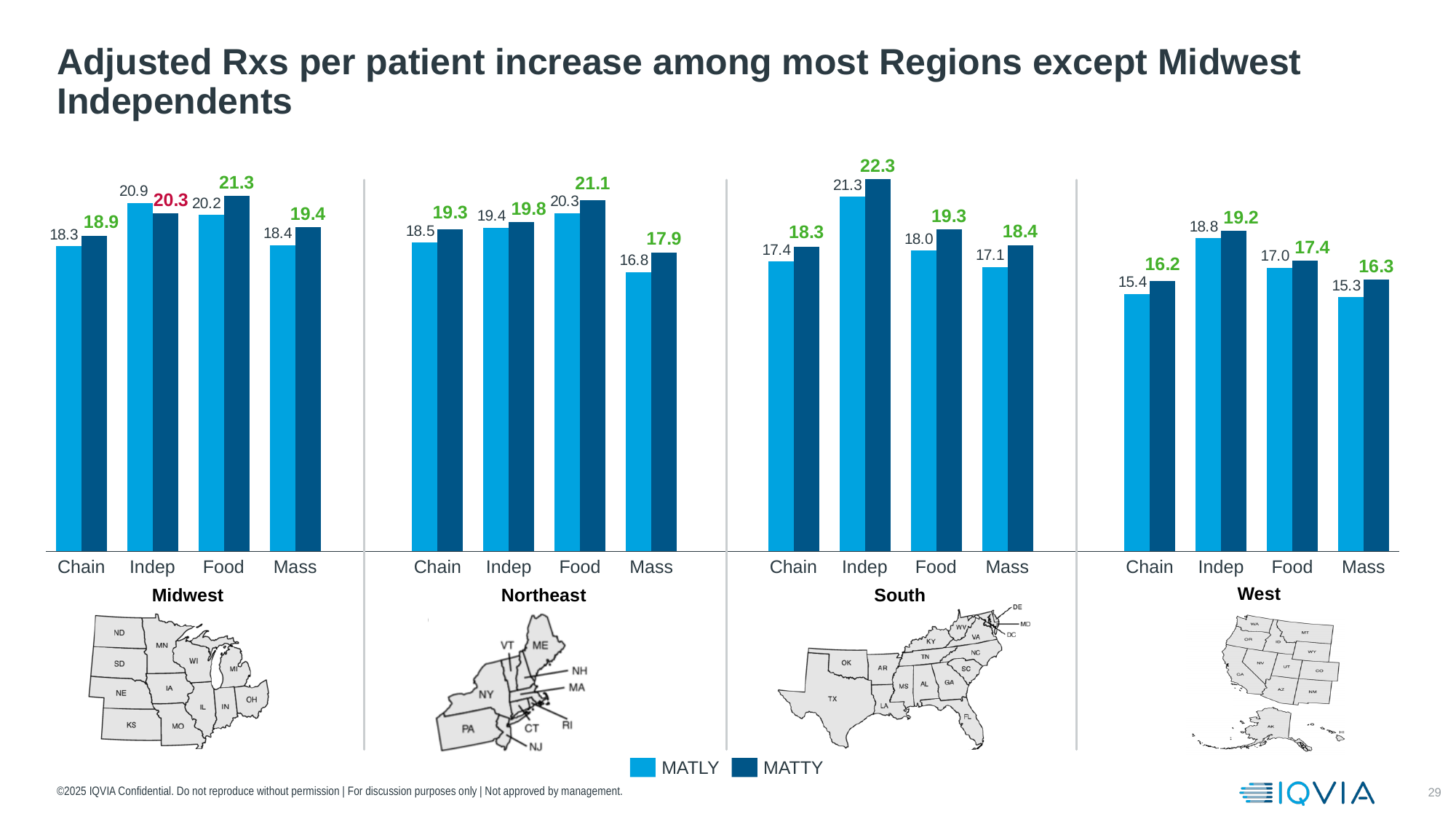
In the Northeast chart, what is the difference between the MATTY and MATLY values for Mass? 1.1 Which series is shown in the darker blue colour in the legend? MATTY In the West chart, which category has the lowest MATLY value? Mass In the South chart, what is the MATLY value for Chain? 17.4 How many series does the legend list? 2 In the Midwest chart, what is the MATTY value for Indep? 20.3 In the West chart, what is the MATTY value for Mass? 16.3 In the Midwest chart, is the MATTY value for Indep larger or smaller than the MATLY value for Indep? smaller In the Midwest chart, what is the MATLY value for Food? 20.2 In the Northeast chart, how many categories are shown on the x axis? 4 What kind of chart is used for the South region? bar chart In the South chart, which category has the highest MATTY value? Indep